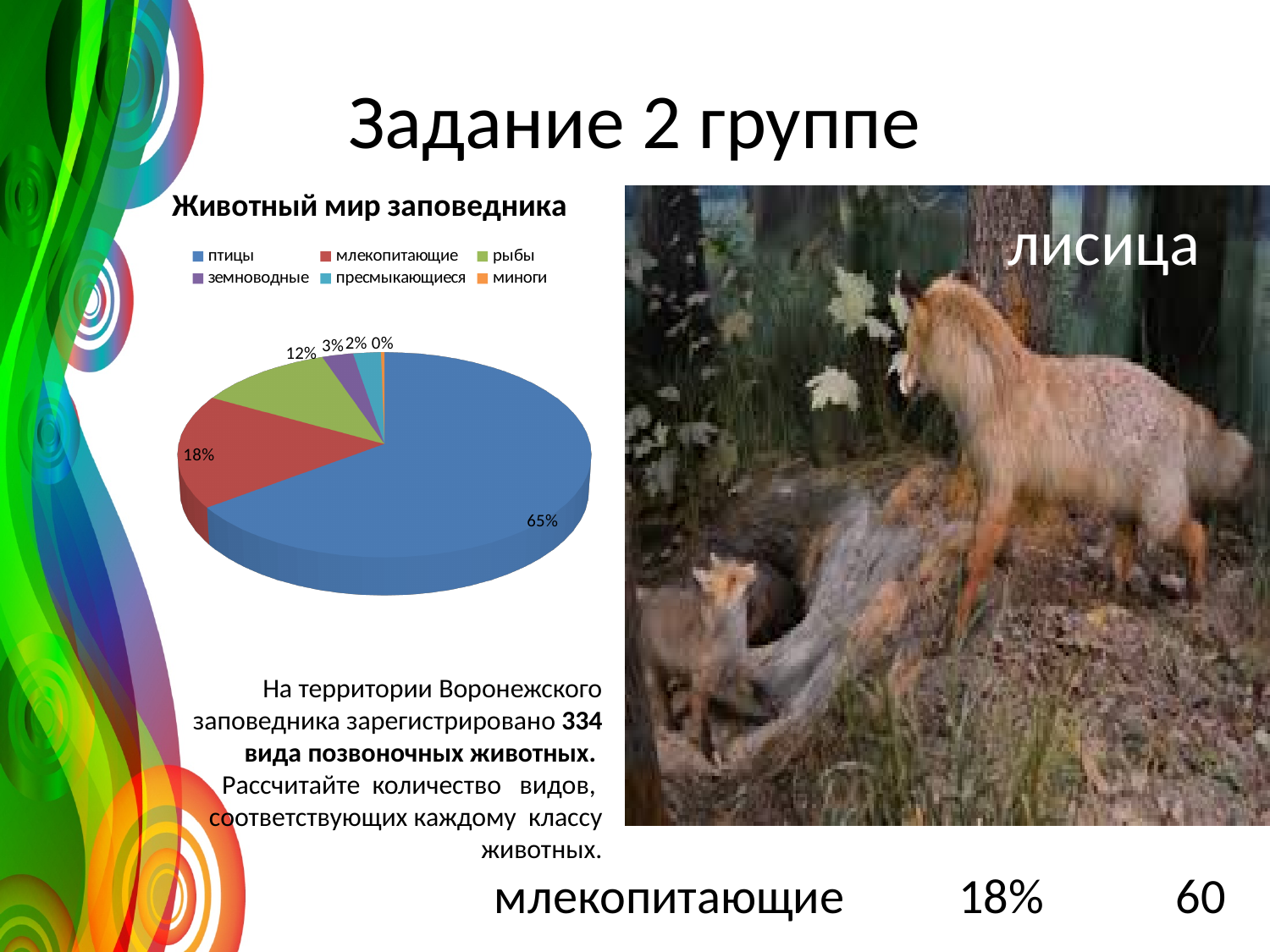
What is the title of the chart? Животный мир заповедника What type of chart is shown on the slide? pie chart Which category has the smallest slice of the pie? миноги How many categories does the legend of the pie chart list? 6 What is the difference between the shares of птицы and млекопитающие? 47% What share of the pie does рыбы have? 12% What share of the pie does земноводные have? 3% Which category has the largest slice of the pie? птицы What share of the pie does птицы have? 65%